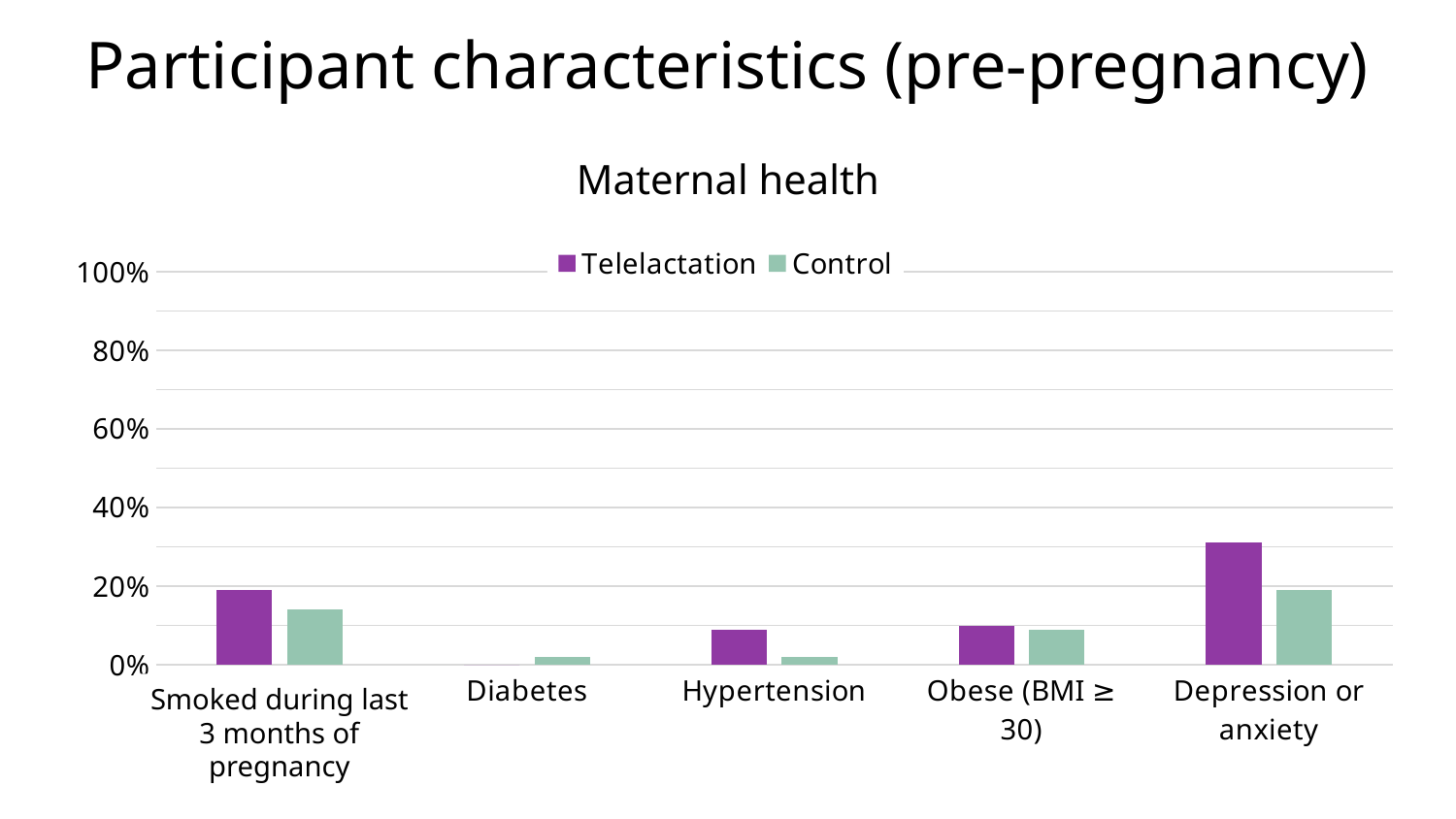
How many series does the legend list? 2 Is the Control value for Smoked during last 3 months of pregnancy greater or less than 20%? less What is the title of the chart? Maternal health What kind of chart is shown on the slide? bar chart Which category has the lowest Telelactation value? Diabetes Which category has the highest Telelactation value? Depression or anxiety Is the Telelactation value for Hypertension greater or less than 20%? less How many categories are shown on the x axis? 5 Is the Telelactation value for Depression or anxiety greater or less than 20%? greater For Depression or anxiety, which series has the larger value, Telelactation or Control? Telelactation Which category has the highest Control value? Depression or anxiety For Smoked during last 3 months of pregnancy, which series has the larger value, Telelactation or Control? Telelactation